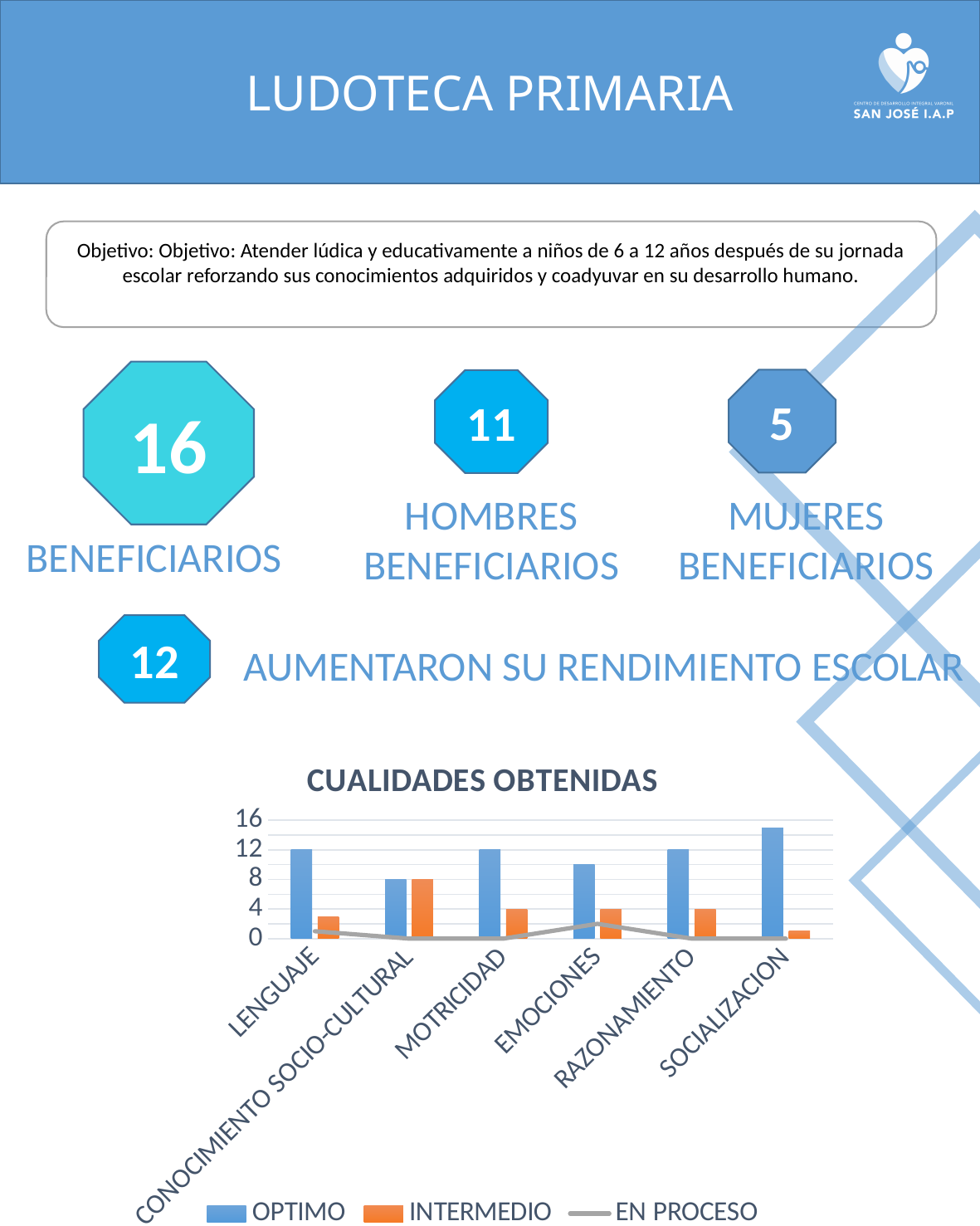
What is the INTERMEDIO value for CONOCIMIENTO SOCIO-CULTURAL in the CUALIDADES OBTENIDAS chart? 8 Which category has the highest INTERMEDIO value in the CUALIDADES OBTENIDAS chart? CONOCIMIENTO SOCIO-CULTURAL Which category has the lowest OPTIMO value in the CUALIDADES OBTENIDAS chart? CONOCIMIENTO SOCIO-CULTURAL How many series does the legend of the CUALIDADES OBTENIDAS chart list? 3 What is the INTERMEDIO value for RAZONAMIENTO in the CUALIDADES OBTENIDAS chart? 4 Is the OPTIMO value for SOCIALIZACION greater or less than 12 in the CUALIDADES OBTENIDAS chart? greater In the CUALIDADES OBTENIDAS chart, which series is larger for LENGUAJE, OPTIMO or INTERMEDIO? OPTIMO How many categories are shown on the x axis of the CUALIDADES OBTENIDAS chart? 6 What type of chart is shown under the title CUALIDADES OBTENIDAS? Combination bar and line chart Which category has the highest OPTIMO value in the CUALIDADES OBTENIDAS chart? SOCIALIZACION In the CUALIDADES OBTENIDAS chart, what is the difference between the OPTIMO and INTERMEDIO values for MOTRICIDAD? 8 What is the OPTIMO value for LENGUAJE in the CUALIDADES OBTENIDAS chart? 12